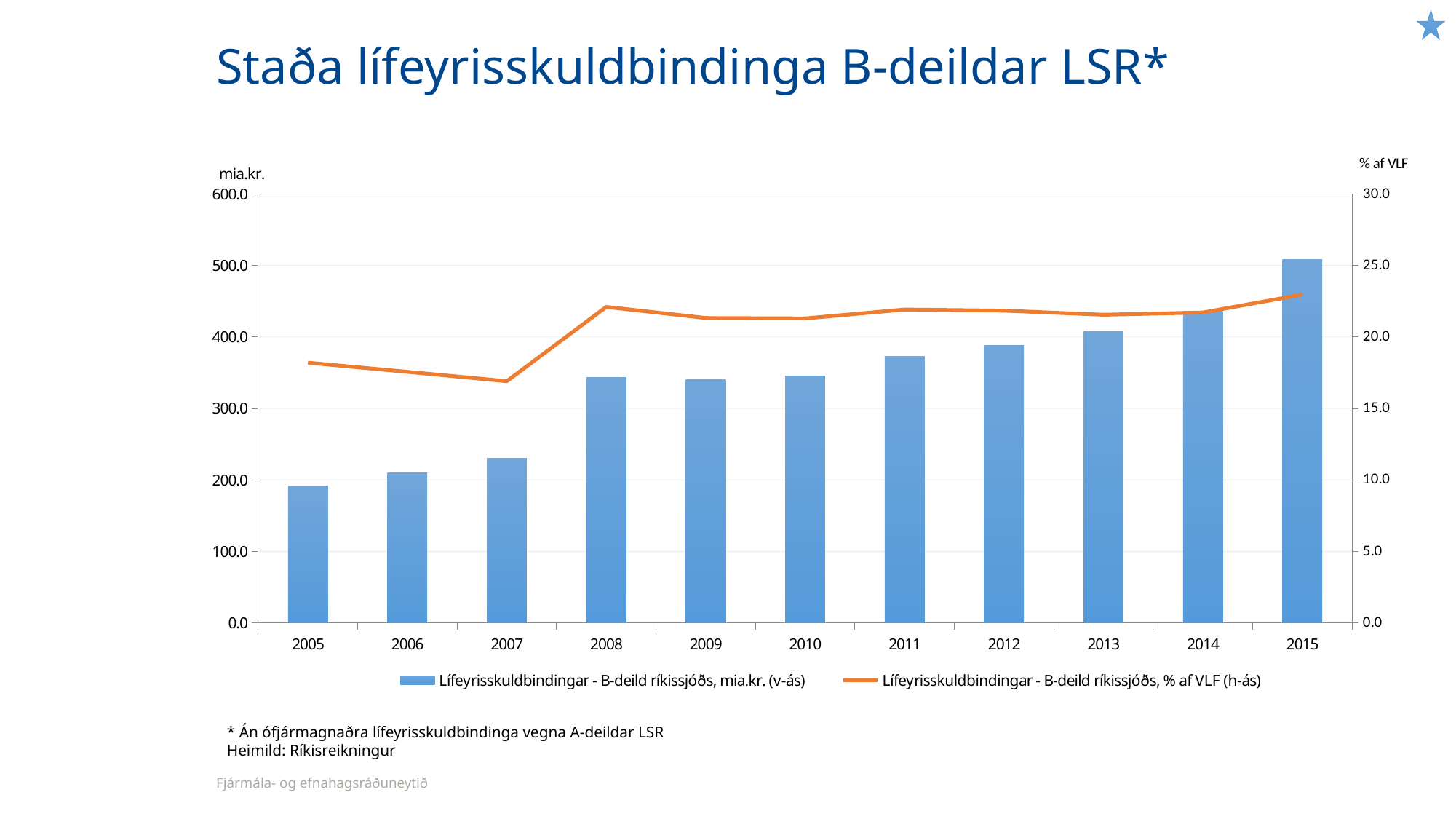
Is the bar value for 2015 (mia.kr.) greater or less than 400? greater Is the bar value for 2005 (mia.kr.) greater or less than 200? less How many series does the legend list? 2 Which year has the highest bar for Lífeyrisskuldbindingar - B-deild ríkissjóðs, mia.kr.? 2015 How many years are shown on the x axis of the chart? 11 Is the bar value for 2014 (mia.kr.) greater or less than 400? greater What is the unit label shown above the left vertical axis? mia.kr. Which year has the larger bar value in mia.kr., 2010 or 2011? 2011 What kind of chart is shown on the slide? A combined bar and line chart In which year is the line for Lífeyrisskuldbindingar as % af VLF at its lowest? 2007 Which year has the lowest bar for Lífeyrisskuldbindingar - B-deild ríkissjóðs, mia.kr.? 2005